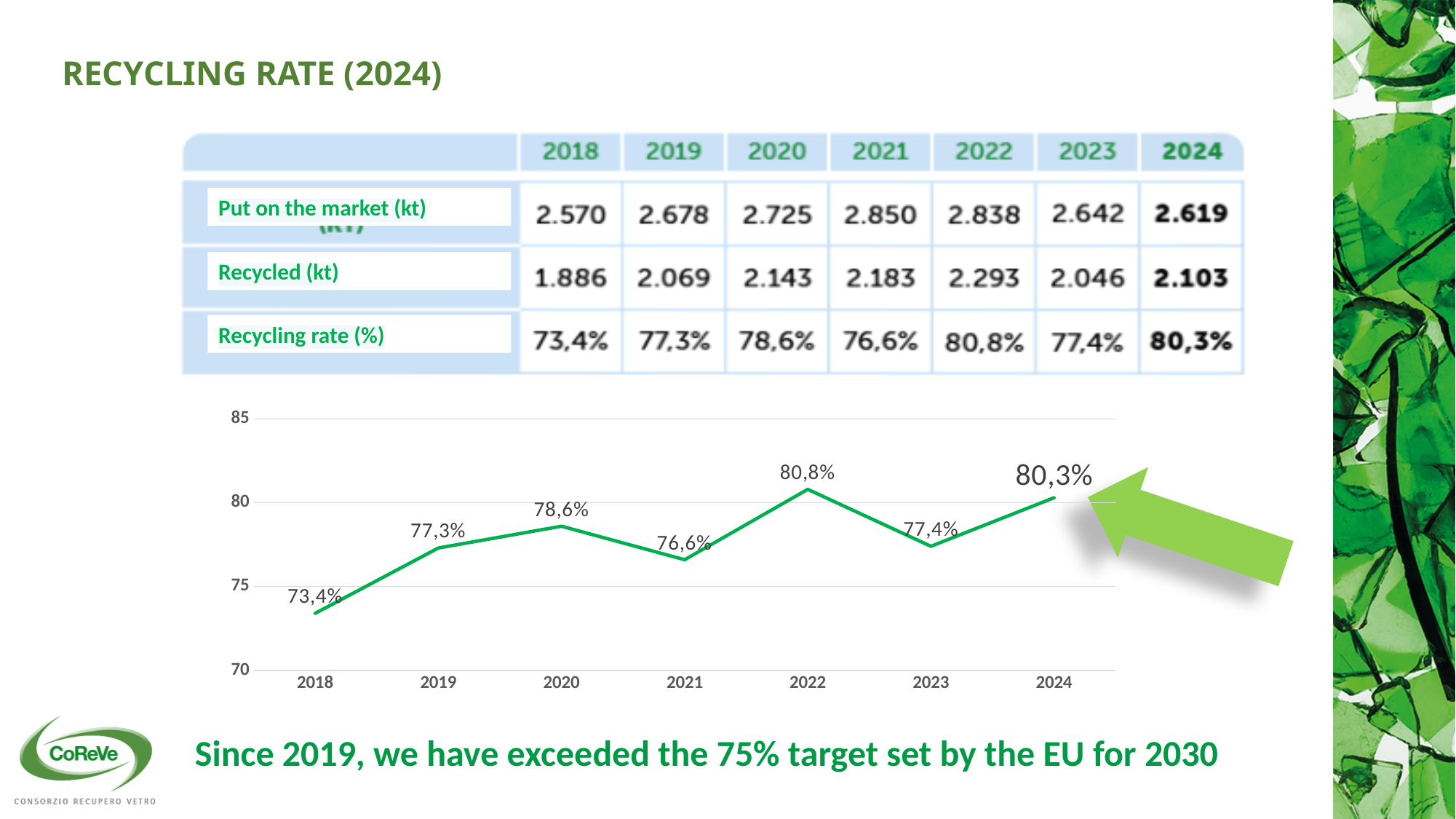
What is the recycling rate shown for 2021 in the line chart? 76,6% What kind of chart is shown on the slide? line chart What colour is the line in the chart? green What is the recycling rate shown for 2024 in the line chart? 80,3% Which year has the lowest recycling rate in the line chart? 2018 Which year has a higher recycling rate, 2020 or 2021? 2020 What is the difference between the recycling rate in 2022 and in 2023? 3,4% What is the recycling rate shown for 2018 in the line chart? 73,4% Which year has the highest recycling rate in the line chart? 2022 Is the recycling rate for 2018 greater or less than 75? less Does the recycling rate rise or fall from 2018 to 2019? rise How many years are plotted on the x axis of the line chart? 7